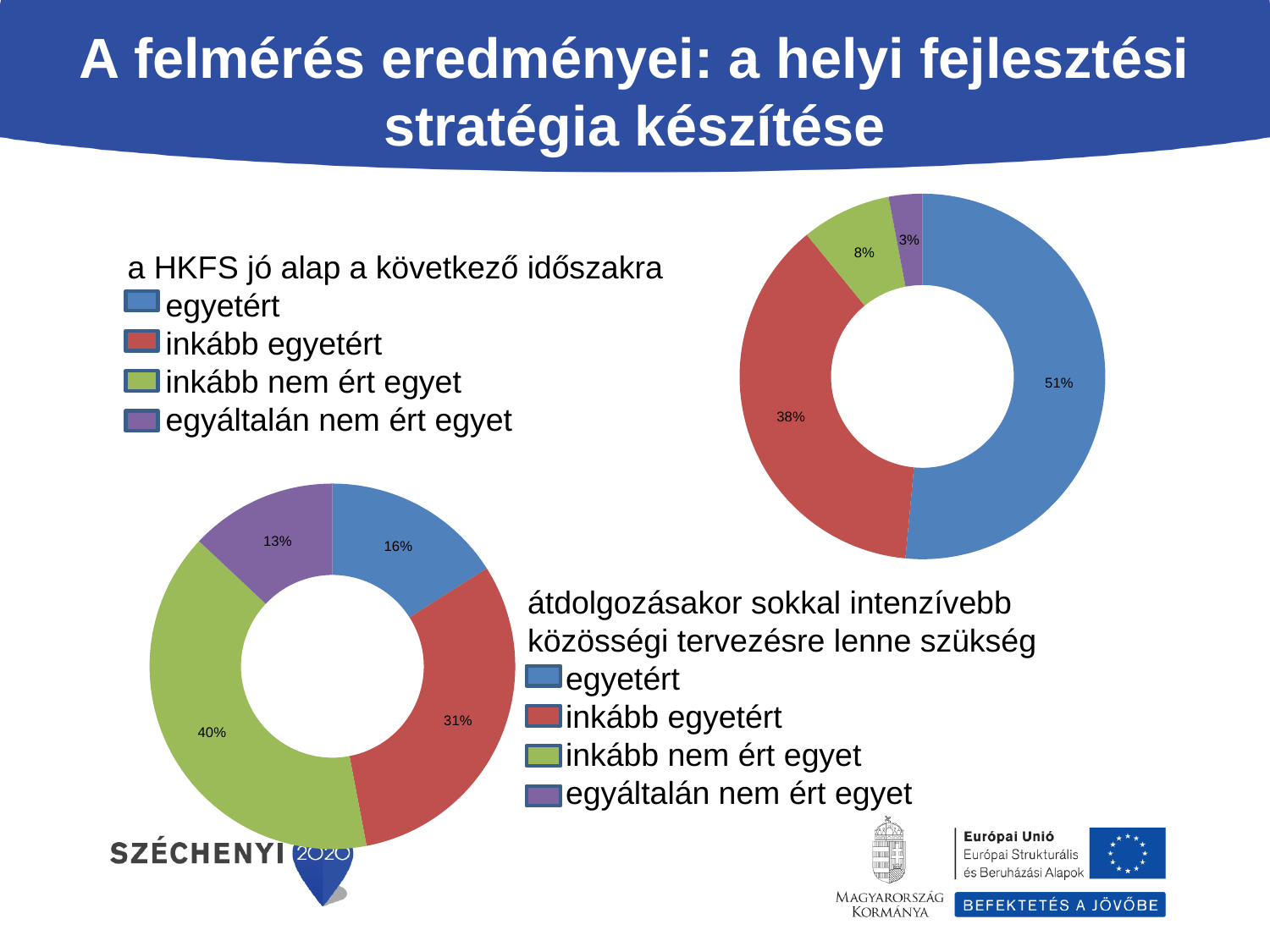
In the top-right chart (a HKFS jó alap a következő időszakra), what share of respondents chose 'inkább egyetért'? 38% In the bottom-left chart (átdolgozásakor sokkal intenzívebb közösségi tervezésre lenne szükség), what share of respondents chose 'inkább nem ért egyet'? 40% In the top-right chart (a HKFS jó alap a következő időszakra), what share of respondents chose 'egyetért'? 51% In the bottom-left chart (átdolgozásakor sokkal intenzívebb közösségi tervezésre lenne szükség), which category has the largest share? inkább nem ért egyet In the top-right chart, which colour represents 'inkább nem ért egyet'? Green In the top-right chart (a HKFS jó alap a következő időszakra), what is the difference between the 'egyetért' and 'inkább egyetért' shares? 13 percentage points What kind of chart is the bottom-left chart? Doughnut (pie) chart In the bottom-left chart (átdolgozásakor sokkal intenzívebb közösségi tervezésre lenne szükség), which is larger: 'inkább egyetért' or 'egyáltalán nem ért egyet'? inkább egyetért In the bottom-left chart (átdolgozásakor sokkal intenzívebb közösségi tervezésre lenne szükség), what share of respondents chose 'egyetért'? 16% How many categories does the legend of the top-right chart list? 4 In the top-right chart (a HKFS jó alap a következő időszakra), which category has the smallest share? egyáltalán nem ért egyet In the bottom-left chart (átdolgozásakor sokkal intenzívebb közösségi tervezésre lenne szükség), what is the combined share of 'egyetért' and 'inkább egyetért'? 47%